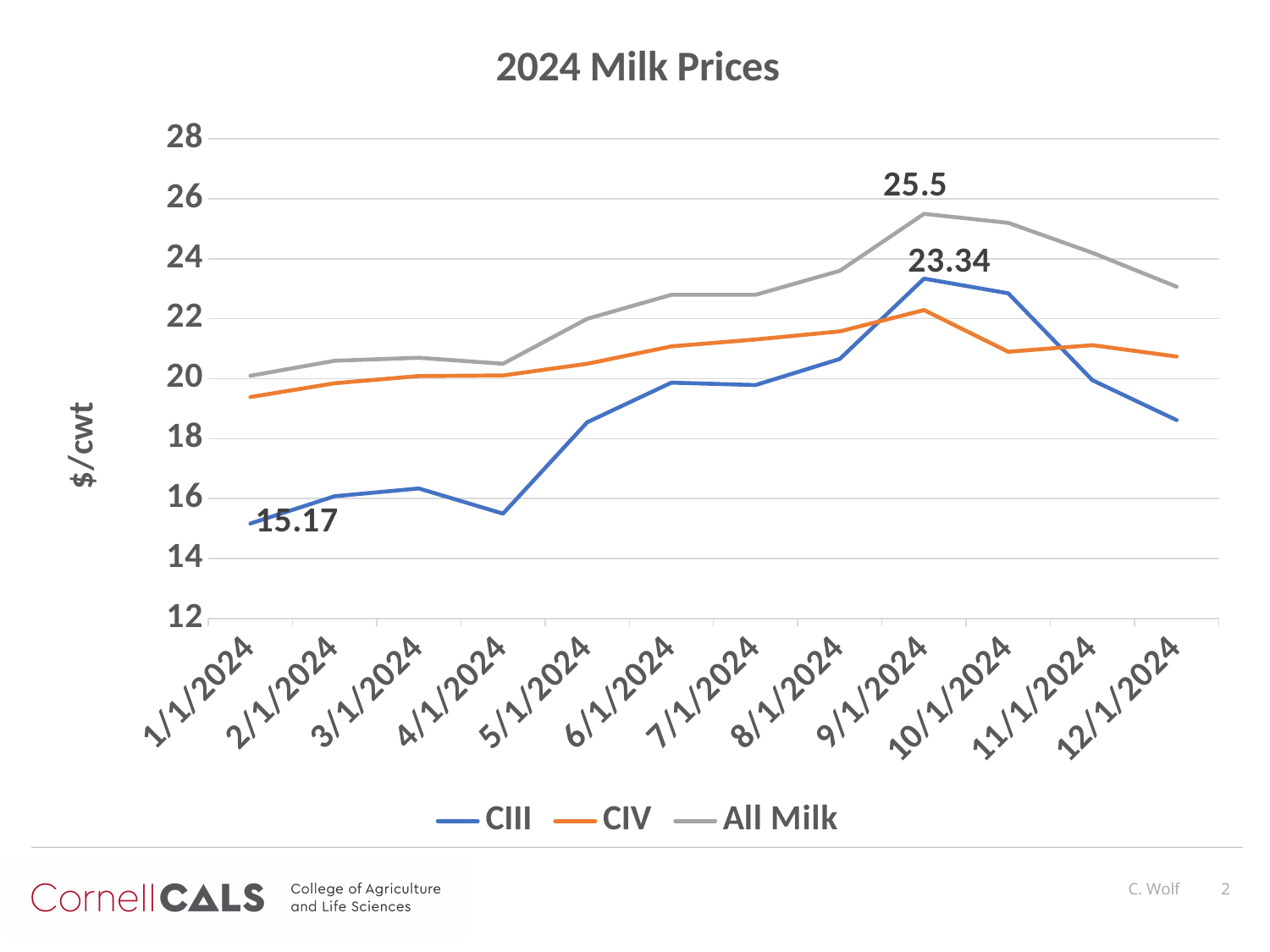
On 9/1/2024, how much higher is the All Milk price than the CIII price? 2.16 What is the All Milk price on 9/1/2024? 25.5 On which date does the CIII series reach its highest value? 9/1/2024 On 9/1/2024, which is higher, CIII or CIV? CIII What is the label on the y axis? $/cwt What is the CIII price on 1/1/2024? 15.17 Is the CIII value on 4/1/2024 greater or less than 16? less What kind of chart is shown on the slide? line chart By how much did the CIII price rise from 1/1/2024 to 9/1/2024? 8.17 How many series does the legend list? 3 How many dates are plotted along the x axis? 12 What is the CIII price on 9/1/2024? 23.34